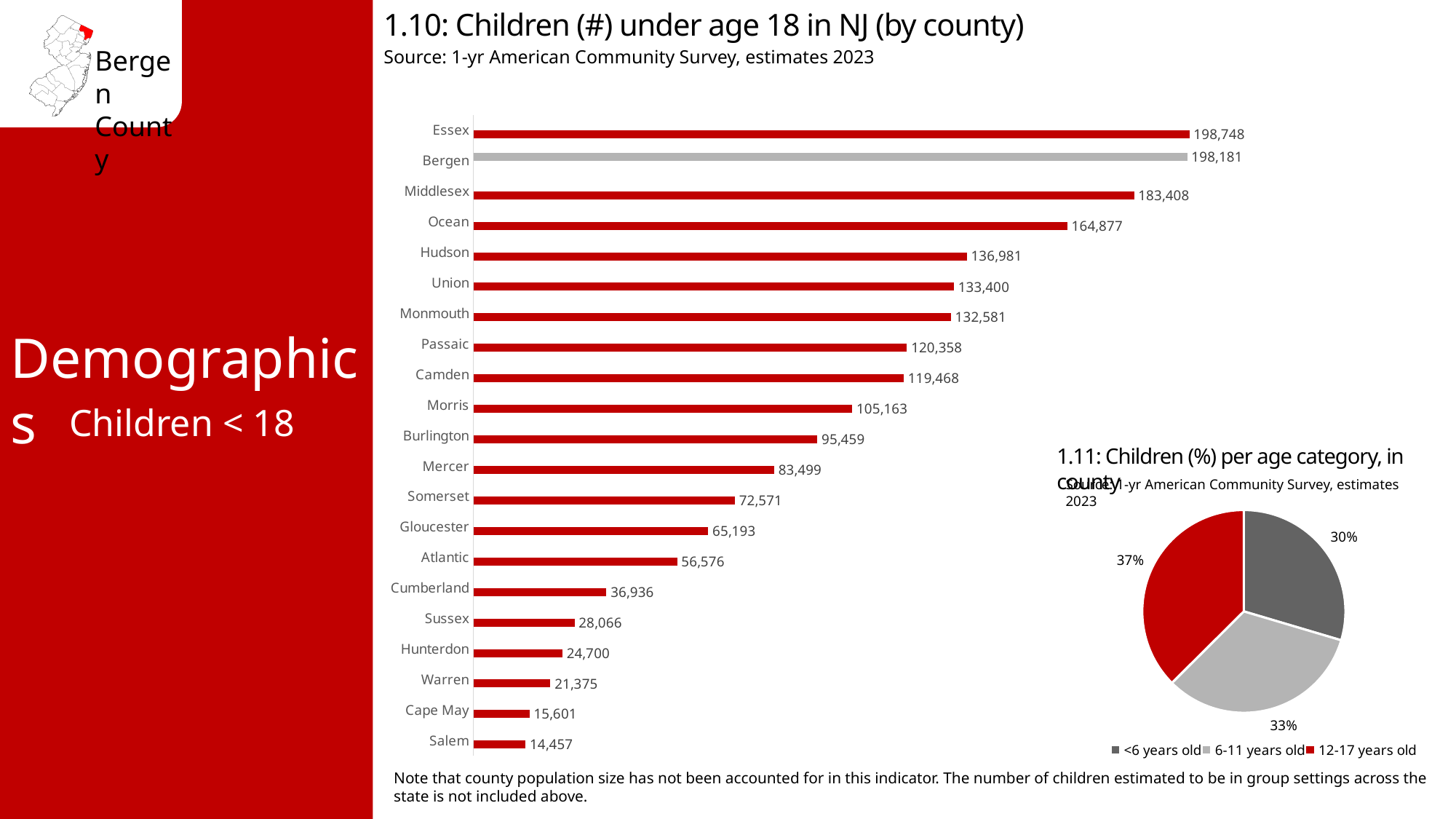
In chart 1.10, which county has the lowest number of children under 18? Salem How many categories does the legend of chart 1.11 list? 3 What type of chart is chart 1.10? Bar chart In chart 1.10, which county has the highest number of children under 18? Essex In chart 1.10, how many counties are plotted? 21 In chart 1.10, which county has more children under 18, Middlesex or Ocean? Middlesex In chart 1.10, what is the value shown for Hudson? 136,981 In chart 1.11 (Children (%) per age category), what share of children are 6-11 years old? 33% In chart 1.11, which age category has the largest share? 12-17 years old In chart 1.10, what is the difference between the values for Essex and Bergen? 567 In chart 1.10 (Children under age 18 in NJ by county), how many children under 18 are shown for Bergen? 198,181 In chart 1.10, which bar is shown in grey rather than red? Bergen